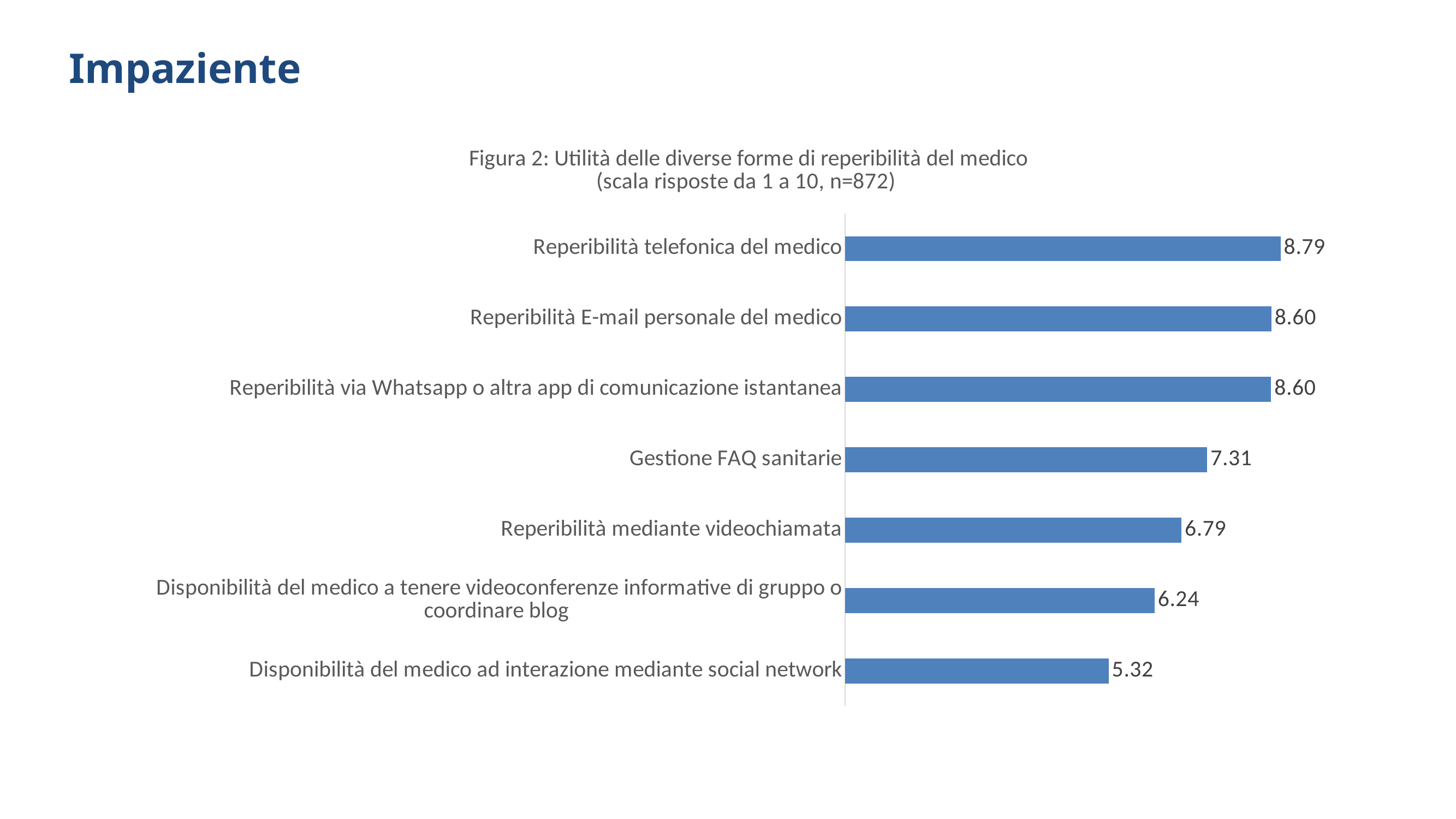
Which category has the lowest value? Disponibilità del medico ad interazione mediante social network How many categories are shown in the chart? 7 What is the difference between the values for Reperibilità telefonica del medico and Disponibilità del medico ad interazione mediante social network? 3.47 What kind of chart is shown on the slide? Bar chart What is the sample size (n) stated in the chart title? 872 What is the value for Reperibilità telefonica del medico? 8.79 What is the value for Disponibilità del medico ad interazione mediante social network? 5.32 Which category has the highest value? Reperibilità telefonica del medico What is the difference between the values for Gestione FAQ sanitarie and Reperibilità mediante videochiamata? 0.52 Which is larger: the value for Gestione FAQ sanitarie or the value for Disponibilità del medico a tenere videoconferenze informative di gruppo o coordinare blog? Gestione FAQ sanitarie What is the value for Gestione FAQ sanitarie? 7.31 What is the value for Reperibilità mediante videochiamata? 6.79